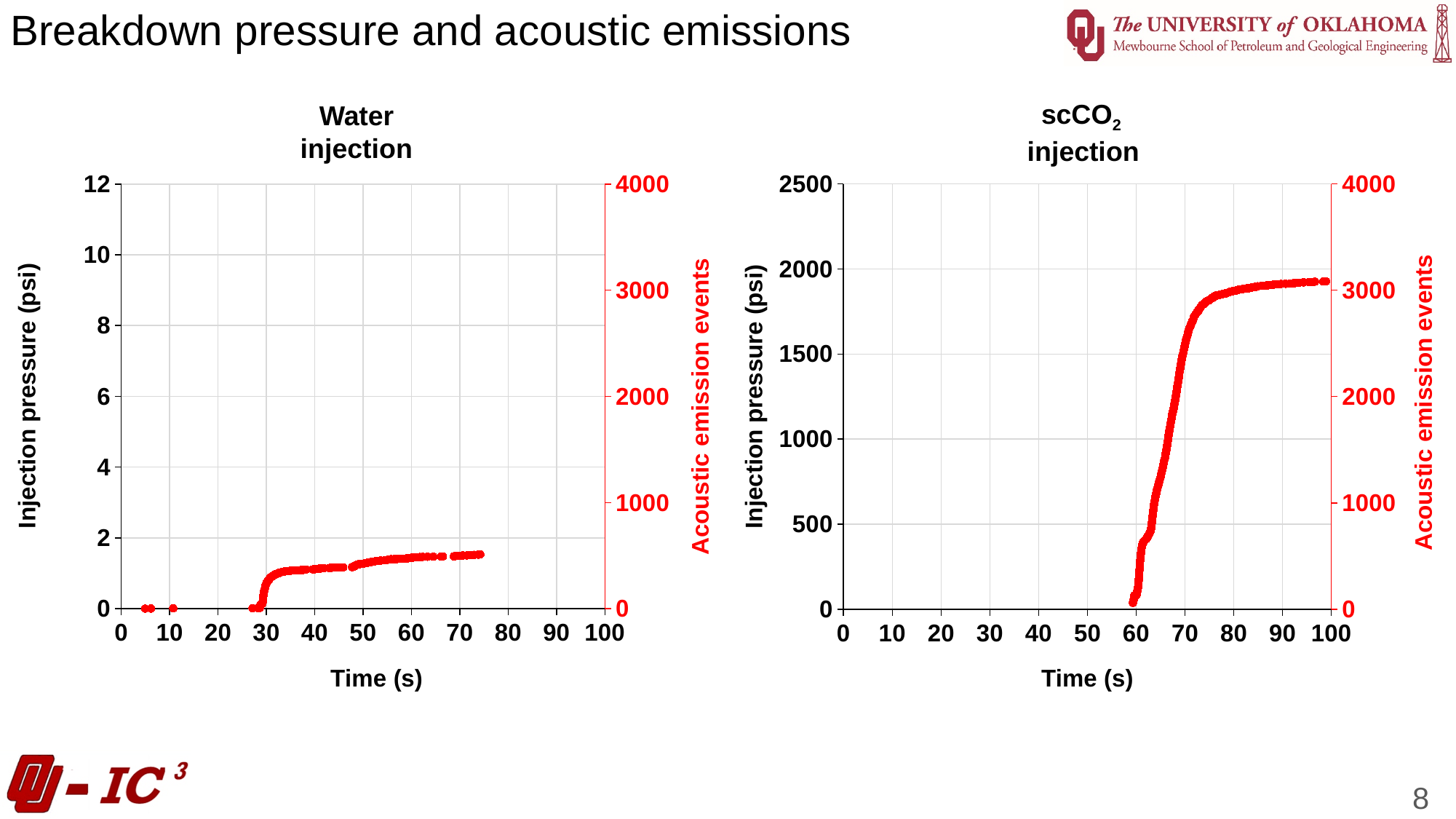
In the Water injection chart, is the number of acoustic emission events at 60 s greater or less than 1000? less In the scCO2 injection chart, do the acoustic emission events rise or fall as time increases? Rise In the scCO2 injection chart, what is the maximum value shown on the right-hand Acoustic emission events axis? 4000 In the Water injection chart, what kind of chart is shown? Scatter chart What is the title of the chart on the left? Water injection In the Water injection chart, do the acoustic emission events rise or fall as time increases? Rise Which chart reaches a higher final number of acoustic emission events, Water injection or scCO2 injection? scCO2 injection What is the title of the chart on the right? scCO2 injection How many charts are shown on the slide? 2 In the Water injection chart, is the number of acoustic emission events at 40 s greater or less than 1000? less In the scCO2 injection chart, is the number of acoustic emission events at 60 s greater or less than 1000? less